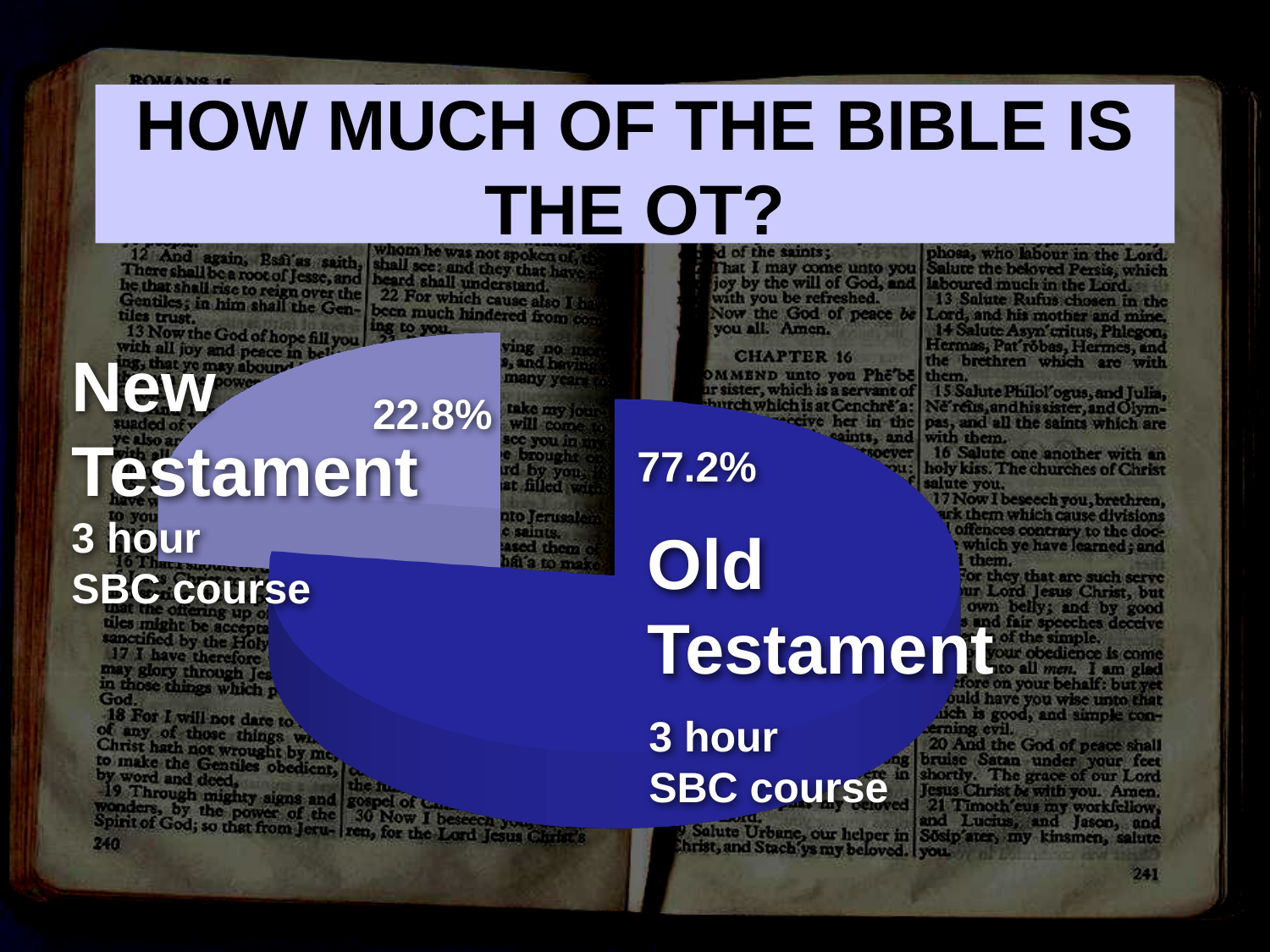
Which is larger, the Old Testament slice or the New Testament slice? Old Testament Which slice of the pie is the smallest? New Testament How many slices does the pie chart have? 2 What kind of chart is shown on the slide? pie chart What share of the pie does the New Testament slice represent? 22.8% What percentage of the Bible is the New Testament according to the chart? 22.8% What is the difference in percentage points between the Old Testament and New Testament slices? 54.4 What percentage of the Bible is the Old Testament according to the chart? 77.2% Which slice of the pie is the largest? Old Testament What is the title of the slide containing the chart? HOW MUCH OF THE BIBLE IS THE OT? What colour is the Old Testament slice? dark blue